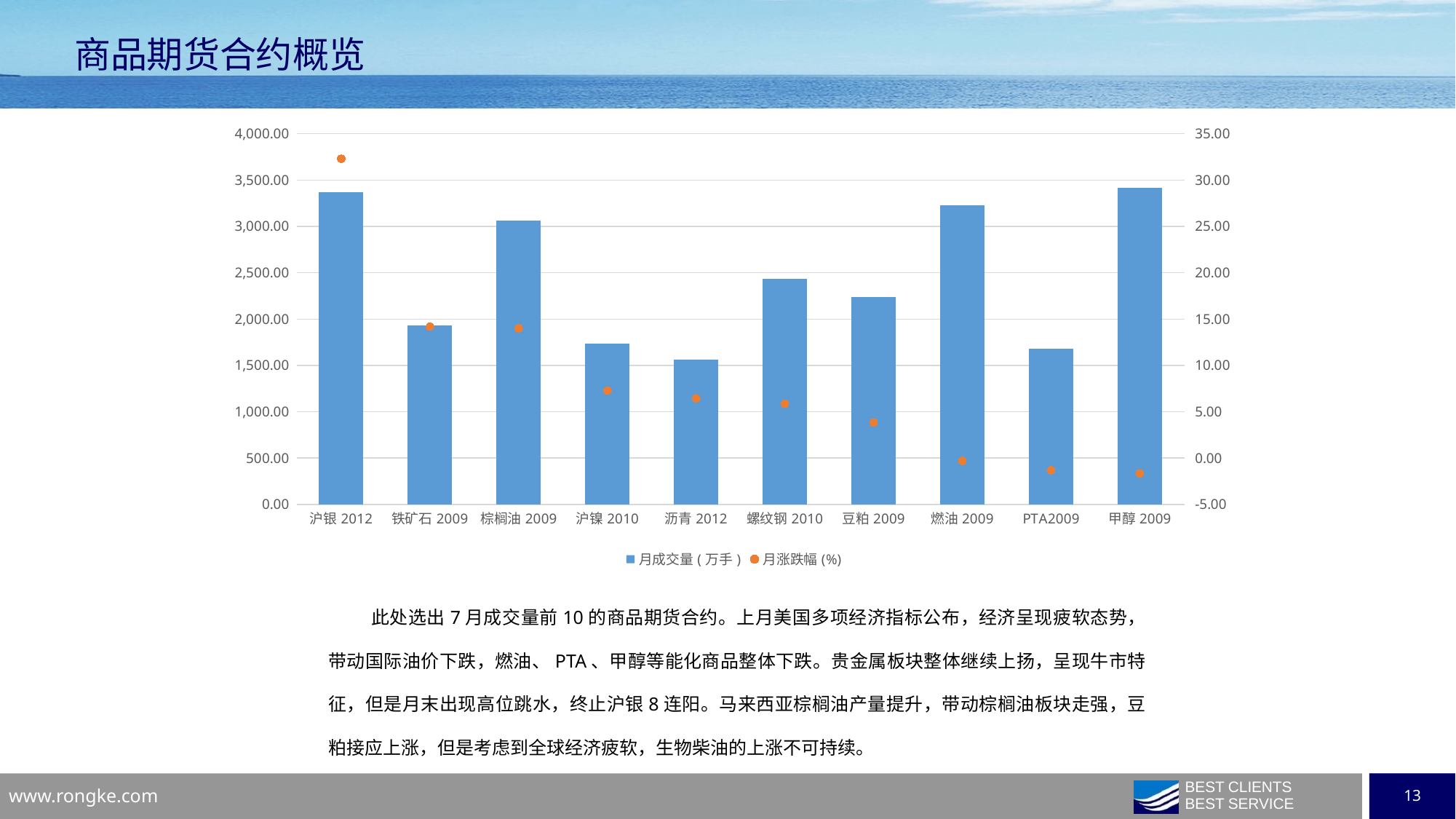
Is the 月成交量 (万手) for 燃油 2009 greater or less than 3,000.00? greater Which has the larger 月成交量 (万手), 棕榈油 2009 or 豆粕 2009? 棕榈油 2009 Is the 月涨跌幅 (%) for 沪银 2012 greater or less than 30.00? greater Which contract has the highest 月涨跌幅 (%) marker? 沪银 2012 What are the two series names shown in the chart legend? 月成交量 (万手) and 月涨跌幅 (%) Is the 月涨跌幅 (%) for 豆粕 2009 greater or less than 5.00? less How many commodity futures contracts are shown on the x axis of the chart? 10 What kind of chart is used to show 月成交量 (万手)? bar chart Which contract has the lowest 月成交量 (万手) bar? 沥青 2012 How many series does the chart legend list? 2